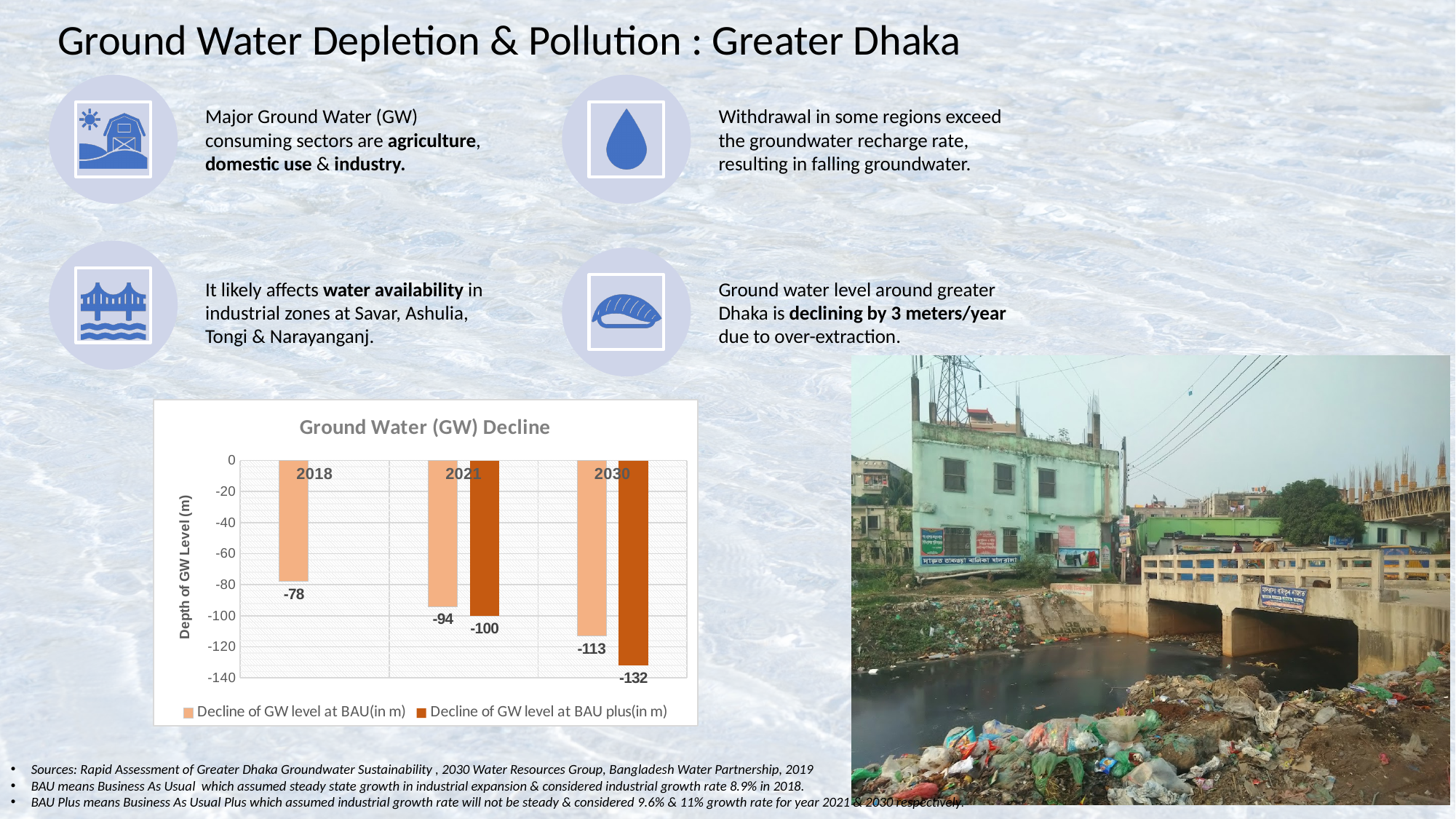
What is the decline of GW level at BAU (in m) for 2030? -113 What is the decline of GW level at BAU plus (in m) for 2030? -132 Do the BAU values rise or fall from 2018 to 2030? fall What type of chart is shown on the slide? bar chart What is the difference between the BAU and BAU plus values for 2030? 19 What is the decline of GW level at BAU (in m) for 2021? -94 What is the title of the chart? Ground Water (GW) Decline What is the decline of GW level at BAU (in m) for 2018? -78 Which year has the lowest (most negative) value for decline of GW level at BAU plus? 2030 How many years are shown on the x axis of the chart? 3 How many series does the legend list? 2 What is the decline of GW level at BAU plus (in m) for 2021? -100